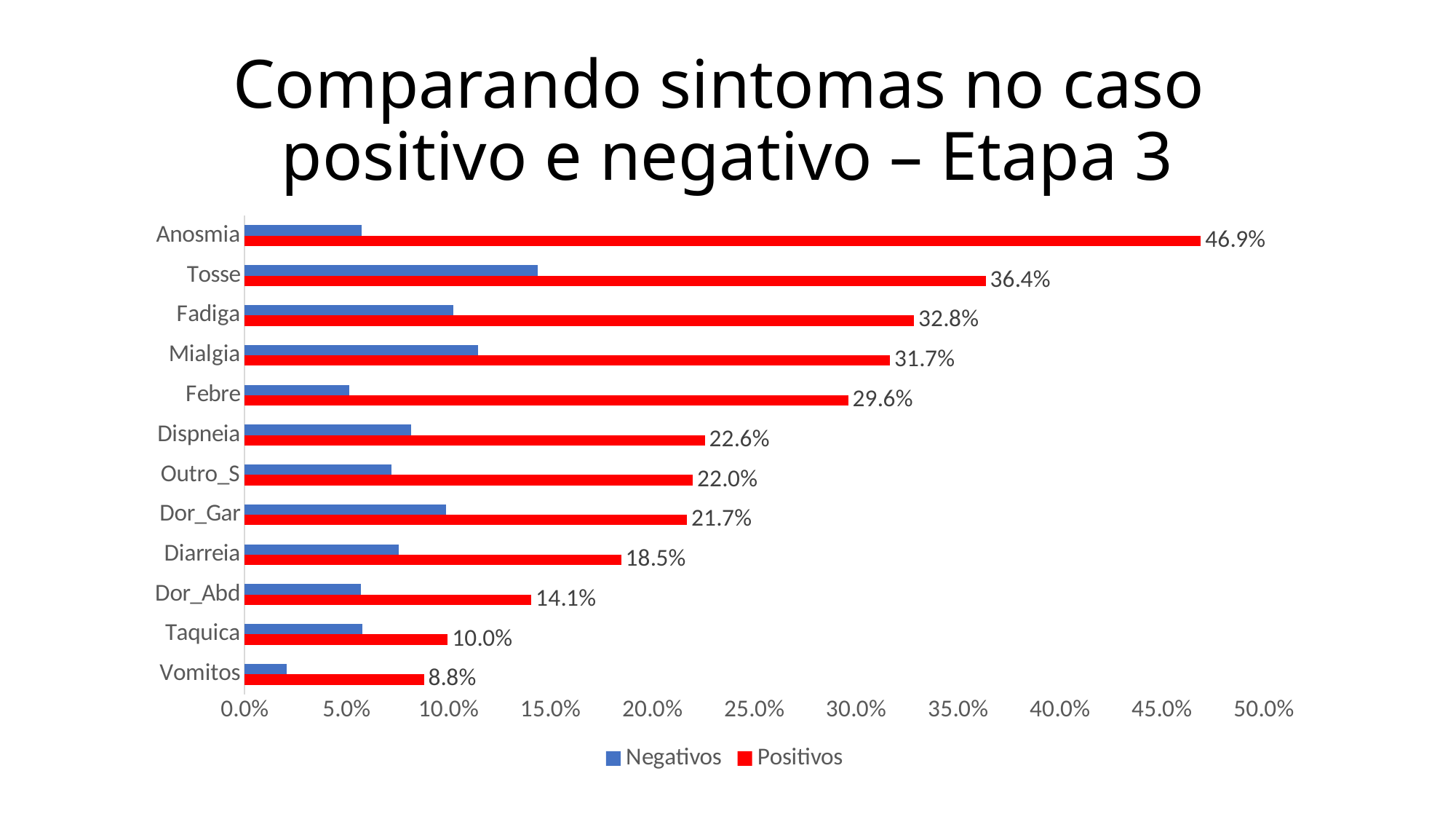
What kind of chart is shown on the slide? Bar chart What is the difference between the Positivos values for Anosmia and Tosse? 10.5% What is the Positivos value for Vomitos? 8.8% Which has a larger Positivos value, Dispneia or Outro_S? Dispneia Which symptom has the lowest Positivos value? Vomitos Which symptom has the highest Positivos value? Anosmia Is the Negativos value for Tosse greater or less than 10.0%? greater What is the Positivos value for Febre? 29.6% How many symptoms are listed on the chart? 12 Is the Negativos value for Vomitos greater or less than 5.0%? less How many series does the legend list? 2 What is the Positivos value for Anosmia? 46.9%